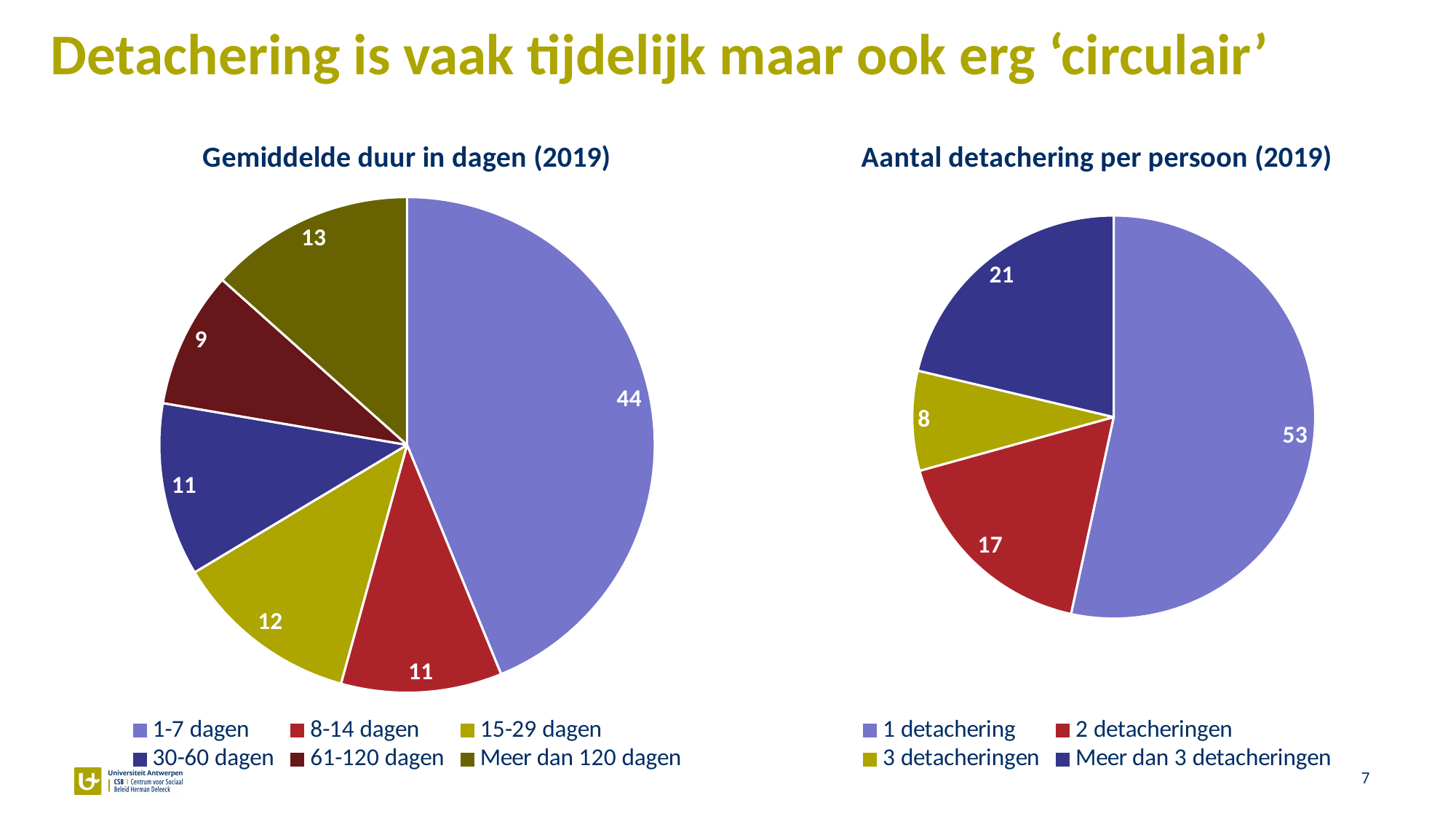
In the chart 'Gemiddelde duur in dagen (2019)', what is the difference between the values for '1-7 dagen' and '15-29 dagen'? 32 In the chart 'Gemiddelde duur in dagen (2019)', what is the value for '1-7 dagen'? 44 In the chart 'Gemiddelde duur in dagen (2019)', which category has the smallest slice? 61-120 dagen In the chart 'Gemiddelde duur in dagen (2019)', what share of the pie does '1-7 dagen' represent? 44% In the chart 'Aantal detachering per persoon (2019)', which category has the largest slice? 1 detachering In the chart 'Gemiddelde duur in dagen (2019)', how many categories does the legend list? 6 In the chart 'Gemiddelde duur in dagen (2019)', what is the value for 'Meer dan 120 dagen'? 13 What type of chart is 'Gemiddelde duur in dagen (2019)'? pie chart In the chart 'Aantal detachering per persoon (2019)', what is the difference between the values for '1 detachering' and 'Meer dan 3 detacheringen'? 32 In the chart 'Aantal detachering per persoon (2019)', how many slices does the pie have? 4 In the chart 'Aantal detachering per persoon (2019)', which is larger: '3 detacheringen' or 'Meer dan 3 detacheringen'? Meer dan 3 detacheringen In the chart 'Aantal detachering per persoon (2019)', what is the value for '2 detacheringen'? 17